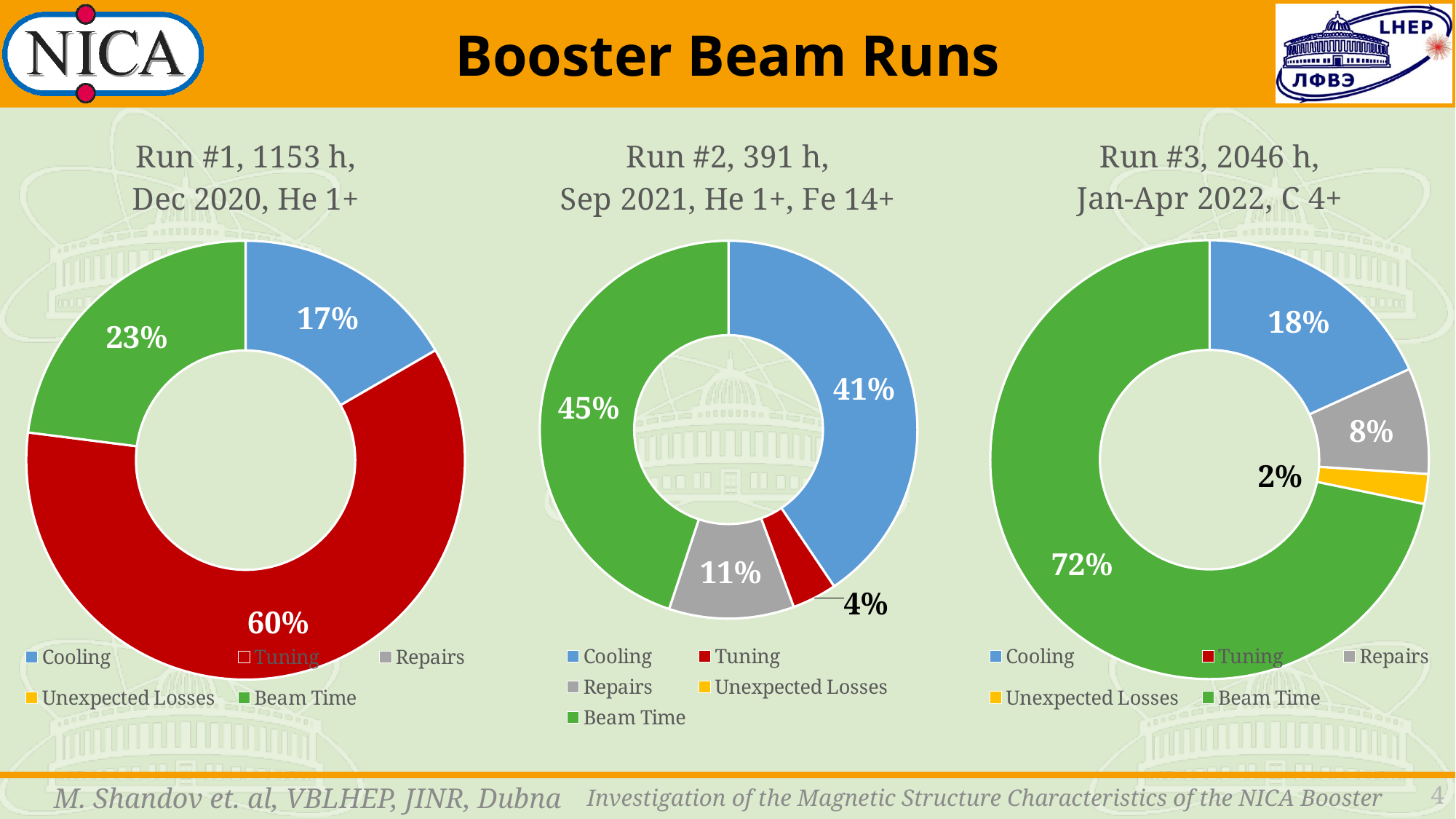
In the Run #2 chart, which is larger, Beam Time or Cooling? Beam Time In the Run #3 chart, what share of time is Unexpected Losses? 2% In the Run #1 chart, what share of time is Tuning? 60% In the Run #2 chart, what share of time is Cooling? 41% In the Run #2 chart, what share of time is Repairs? 11% In the Run #2 chart, which category has the smallest share? Tuning In the Run #1 chart, what is the difference between the Tuning share and the Cooling share? 43% What kind of chart is used for Run #1? Pie (doughnut) chart In the Run #3 chart, what is the difference between the Beam Time share and the Cooling share? 54% In the Run #3 chart, which category has the largest share? Beam Time How many entries does the legend of the Run #2 chart list? 5 In the Run #1 chart, what share of time is Beam Time? 23%